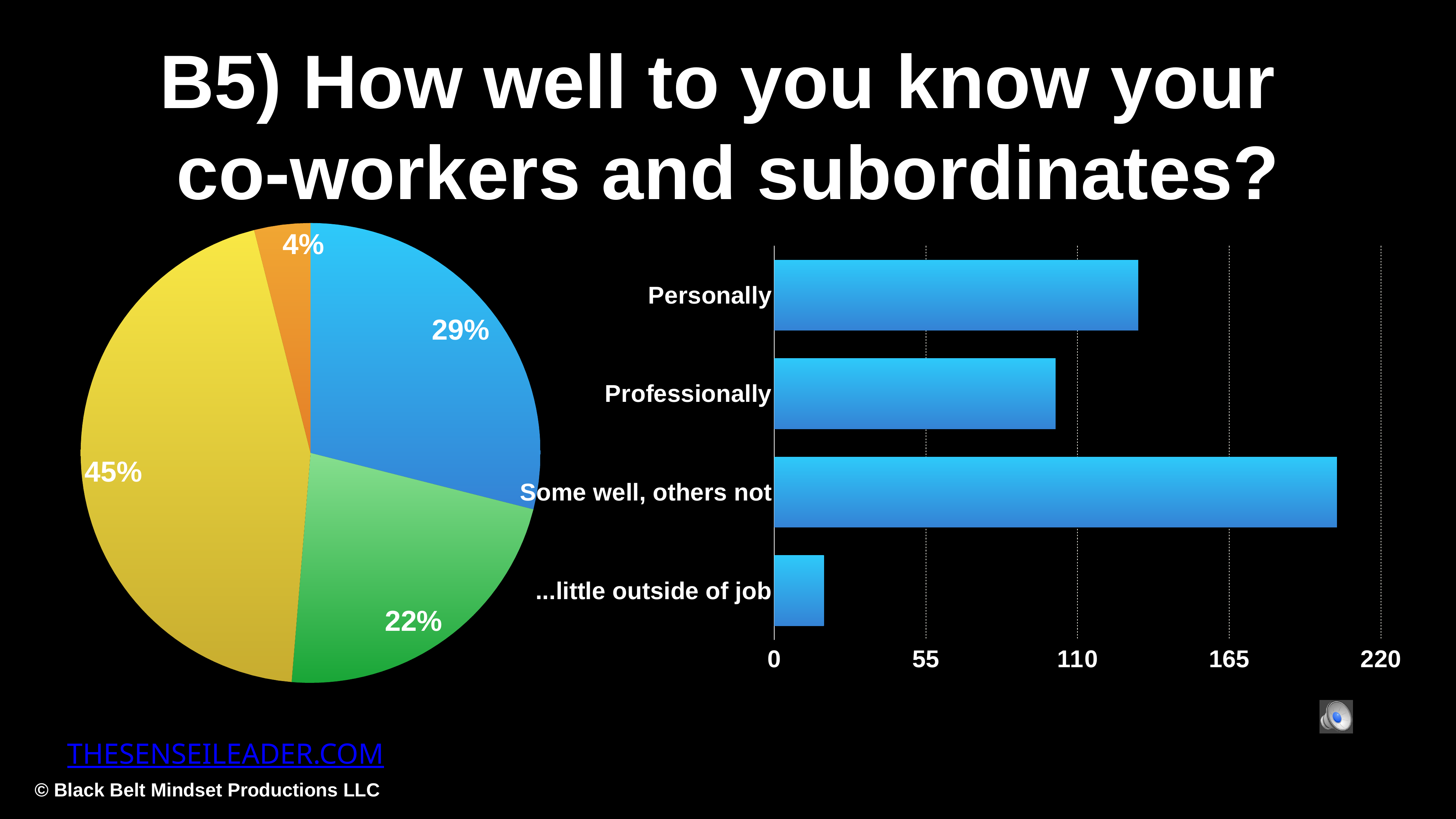
In the bar chart on the right, is the value for Some well, others not greater or less than 165? greater What is the smallest percentage shown on the pie chart on the left? 4% In the bar chart on the right, is the value for Professionally greater or less than 110? less What kind of chart is on the left side of the slide? pie chart How many categories does the bar chart on the right show? 4 In the bar chart on the right, which category has the lowest value? ...little outside of job In the bar chart on the right, which is larger: Personally or Professionally? Personally In the bar chart on the right, which category has the highest value? Some well, others not In the bar chart on the right, is the value for ...little outside of job greater or less than 55? less What is the largest percentage shown on the pie chart on the left? 45% What kind of chart is on the right side of the slide? bar chart